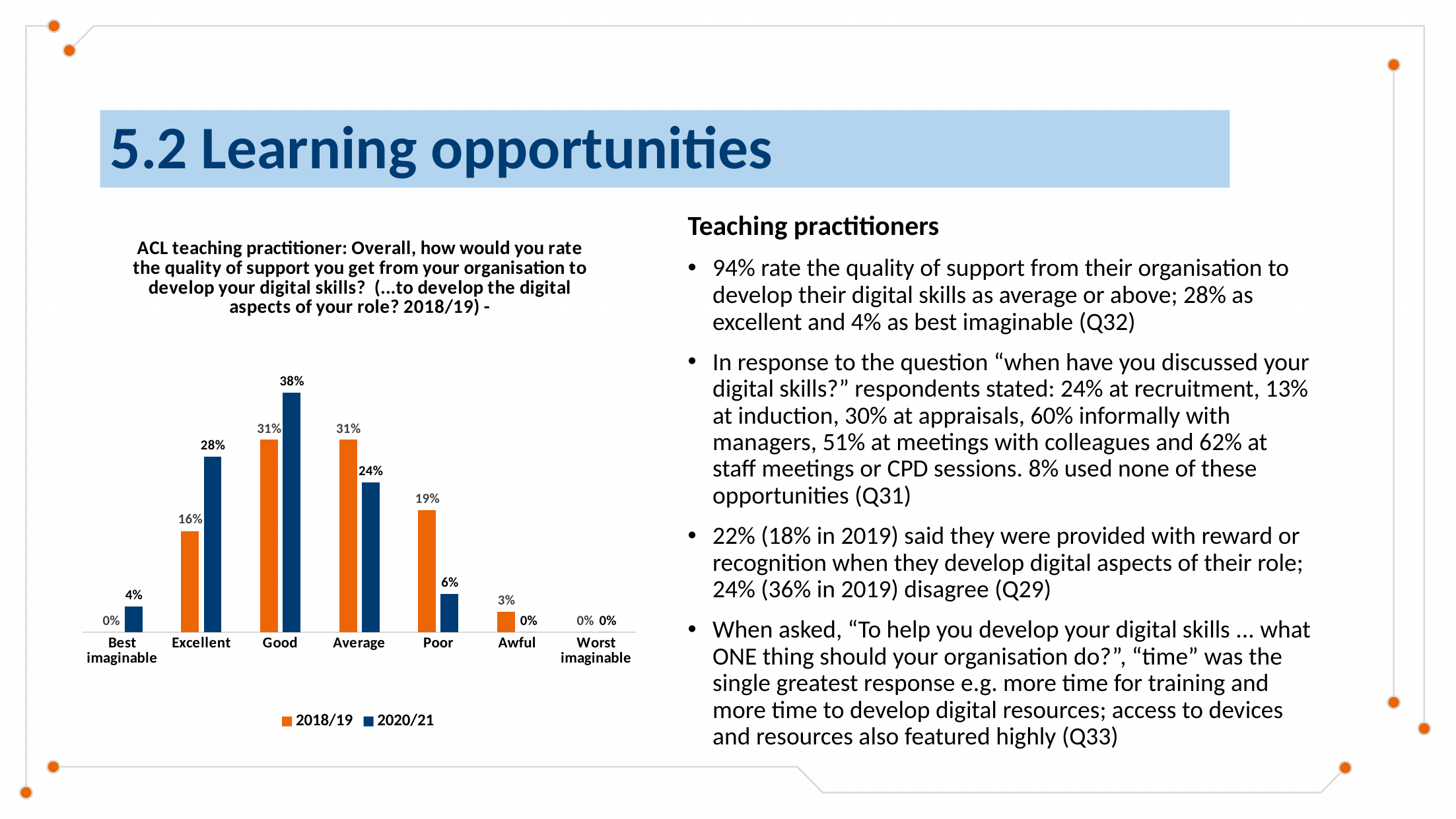
Which category has the highest 2018/19 value for Excellent or Poor? Poor Which colour represents the 2018/19 series in the chart? Orange What is the 2020/21 value for Best imaginable? 4% What is the difference between the 2018/19 and 2020/21 values for Poor? 13% How many series does the chart legend list? 2 Which is larger for Average: the 2018/19 value or the 2020/21 value? 2018/19 What is the difference between the 2020/21 and 2018/19 values for Excellent? 12% What is the 2020/21 value for Good? 38% What is the 2018/19 value for Poor? 19% What type of chart is shown on the slide? Bar chart Which category has the highest 2020/21 value? Good How many rating categories are shown on the x axis of the chart? 7